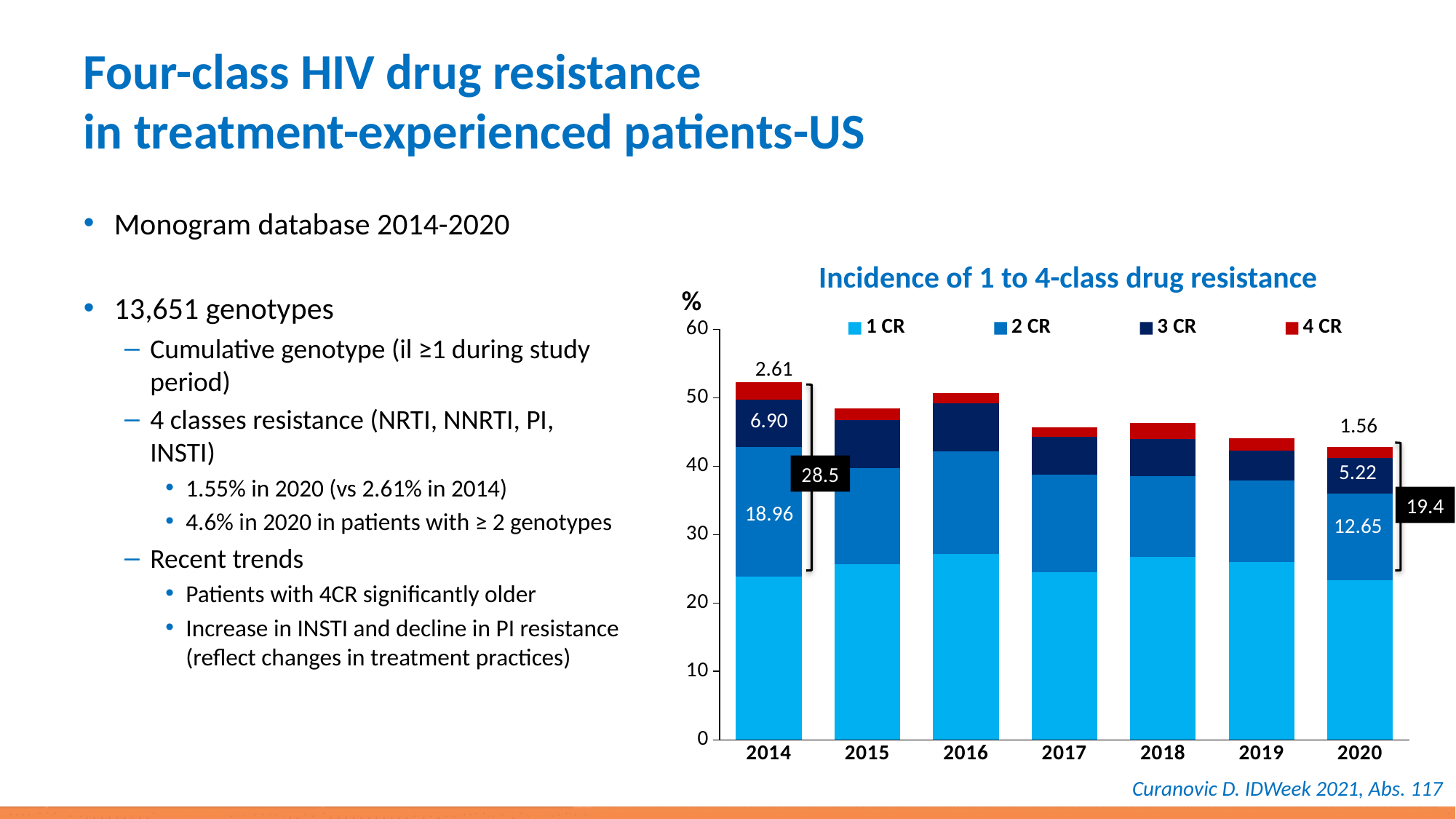
Is the total height of the 2020 stacked bar greater or less than 50? less How many series does the chart legend list? 4 What is the value of the 4 CR segment for 2020? 1.56 What is the title of the chart? Incidence of 1 to 4-class drug resistance What is the value of the 4 CR segment for 2014? 2.61 How many years are shown on the x axis of the chart? 7 What is the value of the 2 CR segment for 2014? 18.96 What is the value of the 3 CR segment for 2020? 5.22 By how much did the 2 CR value decrease from 2014 (18.96) to 2020 (12.65)? 6.31 Is the total height of the 2014 stacked bar greater or less than 50? greater What kind of chart is shown on the slide? stacked bar chart Which year has the larger 3 CR value, 2014 or 2020? 2014